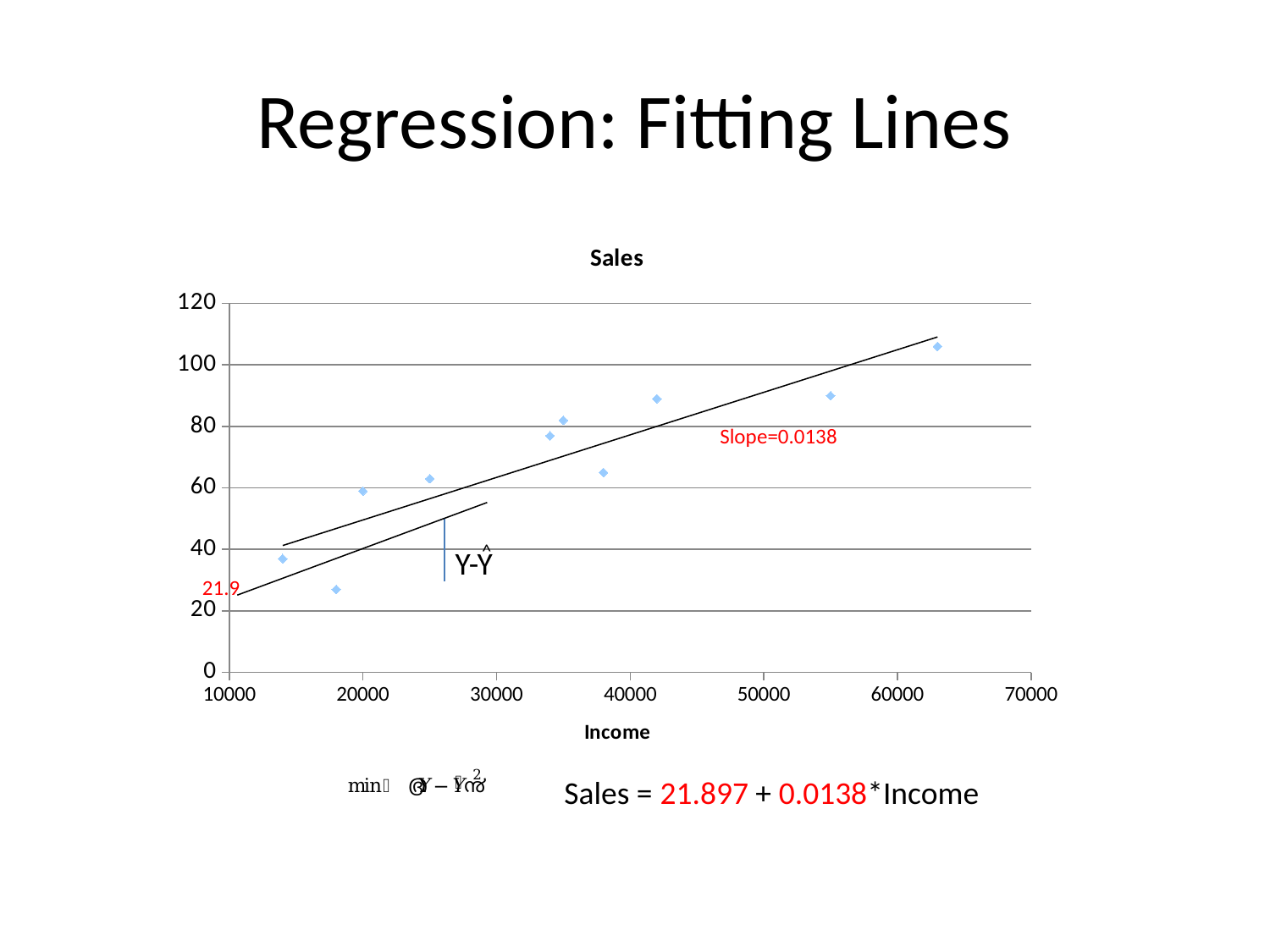
Is the Sales value for the point at an Income of about 55000 greater or less than 80? greater Which point has the highest Sales value: the one at an Income of about 63000 or the one at about 42000? the one at about 63000 Is the Sales value for the point with the highest Income (around 63000) greater or less than 100? greater What is the label on the horizontal axis of the chart? Income What intercept value is annotated in red at the left end of the lower fitted line? 21.9 Do the Sales values generally rise or fall as Income increases along the x axis? rise Is the Sales value for the point at an Income of about 18000 greater or less than 40? less What kind of chart is shown on the slide? scatter chart What is the title of the chart? Sales What is the maximum value shown on the vertical axis of the chart? 120 What slope value is annotated on the chart? 0.0138 How many data points are plotted in the chart? 10